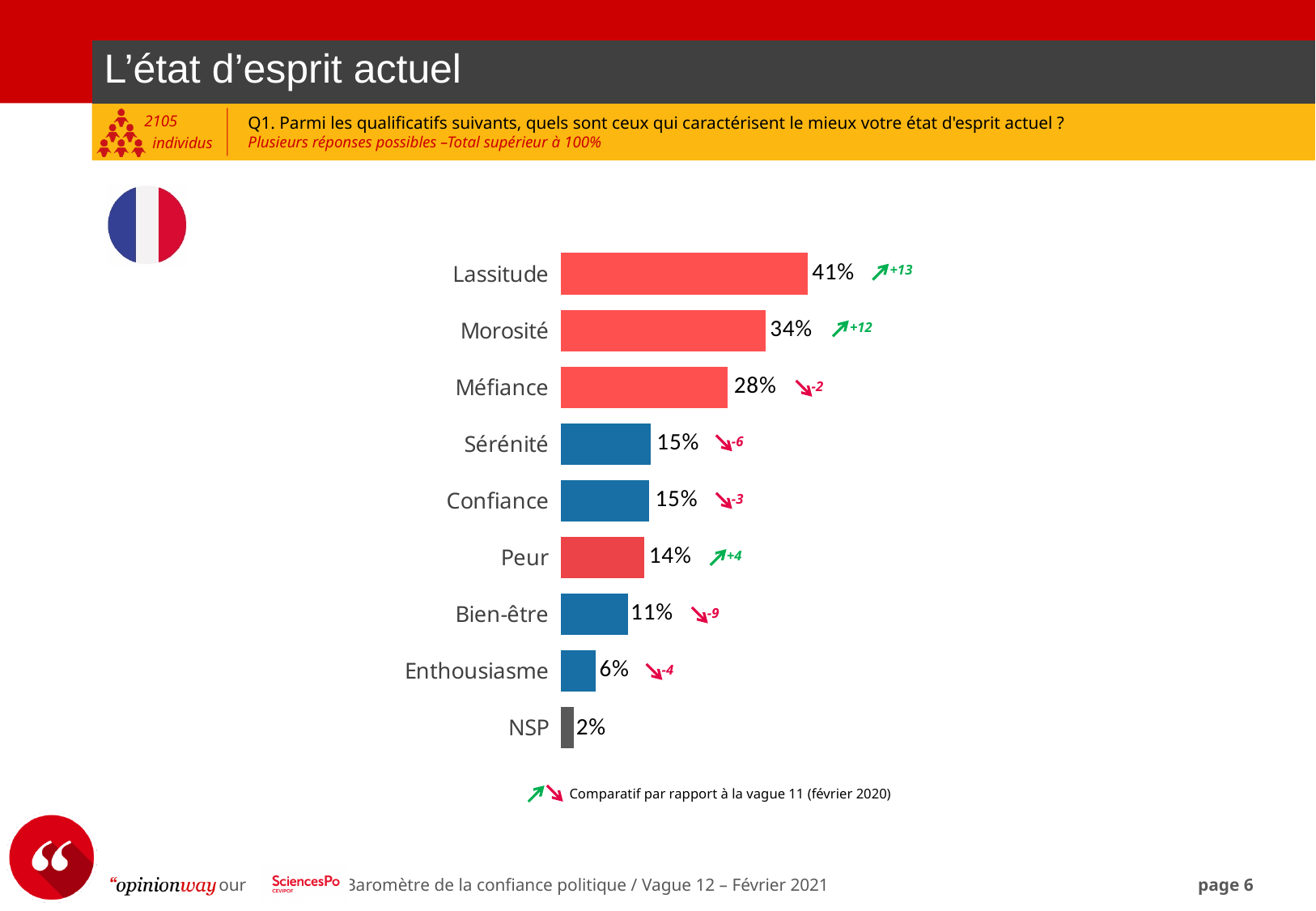
What change compared with the previous wave is shown next to Bien-être? -9 Which is larger, the value for Peur or the value for Bien-être? Peur What change compared with the previous wave is shown next to Lassitude? +13 Which category has the lowest value? NSP What is the difference between the values for Méfiance and Bien-être? 17% Which category has the highest value? Lassitude What is the value for Lassitude? 41% What is the value for Enthousiasme? 6% What kind of chart is shown on the slide? Bar chart How many categories are shown in the chart? 9 What is the difference between the values for Lassitude and Morosité? 7% What is the value for Méfiance? 28%